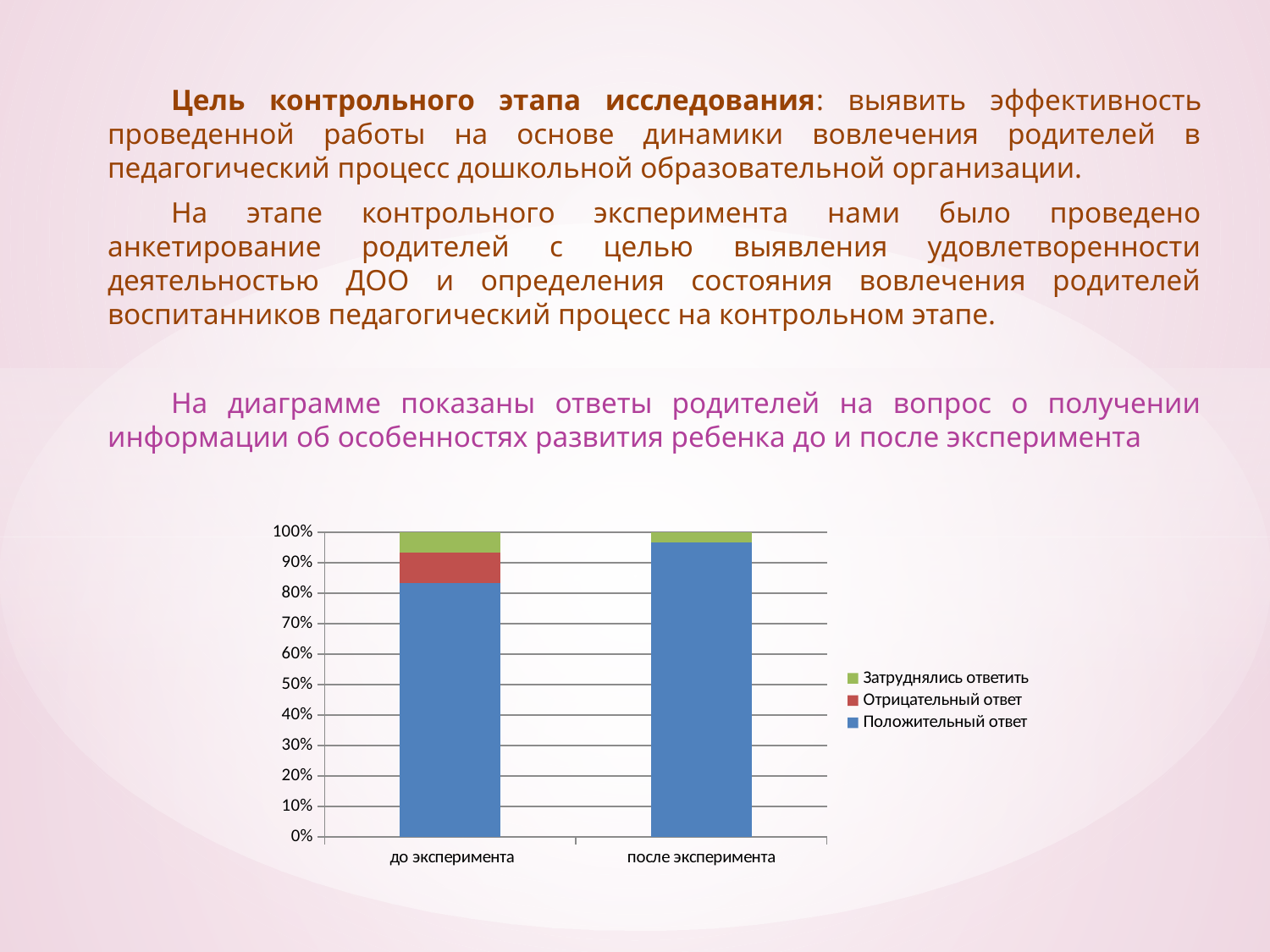
Is the value for "Положительный ответ" in the "после эксперимента" bar greater or less than 90%? greater What kind of chart is shown on the slide? stacked bar chart Which series is shown in green in the chart? Затруднялись ответить Is the value for "Положительный ответ" in the "до эксперимента" bar greater or less than 70%? greater Which category has the larger share of "Отрицательный ответ": "до эксперимента" or "после эксперимента"? до эксперимента What is the label of the first category on the x axis of the chart? до эксперимента Which category has the larger share of "Положительный ответ": "до эксперимента" or "после эксперимента"? после эксперимента How many series does the chart legend list? 3 Which series is shown in blue in the chart? Положительный ответ Is the value for "Положительный ответ" in the "до эксперимента" bar greater or less than 90%? less How many categories are shown on the x axis of the chart? 2 Does the share of "Положительный ответ" rise or fall from "до эксперимента" to "после эксперимента"? rise